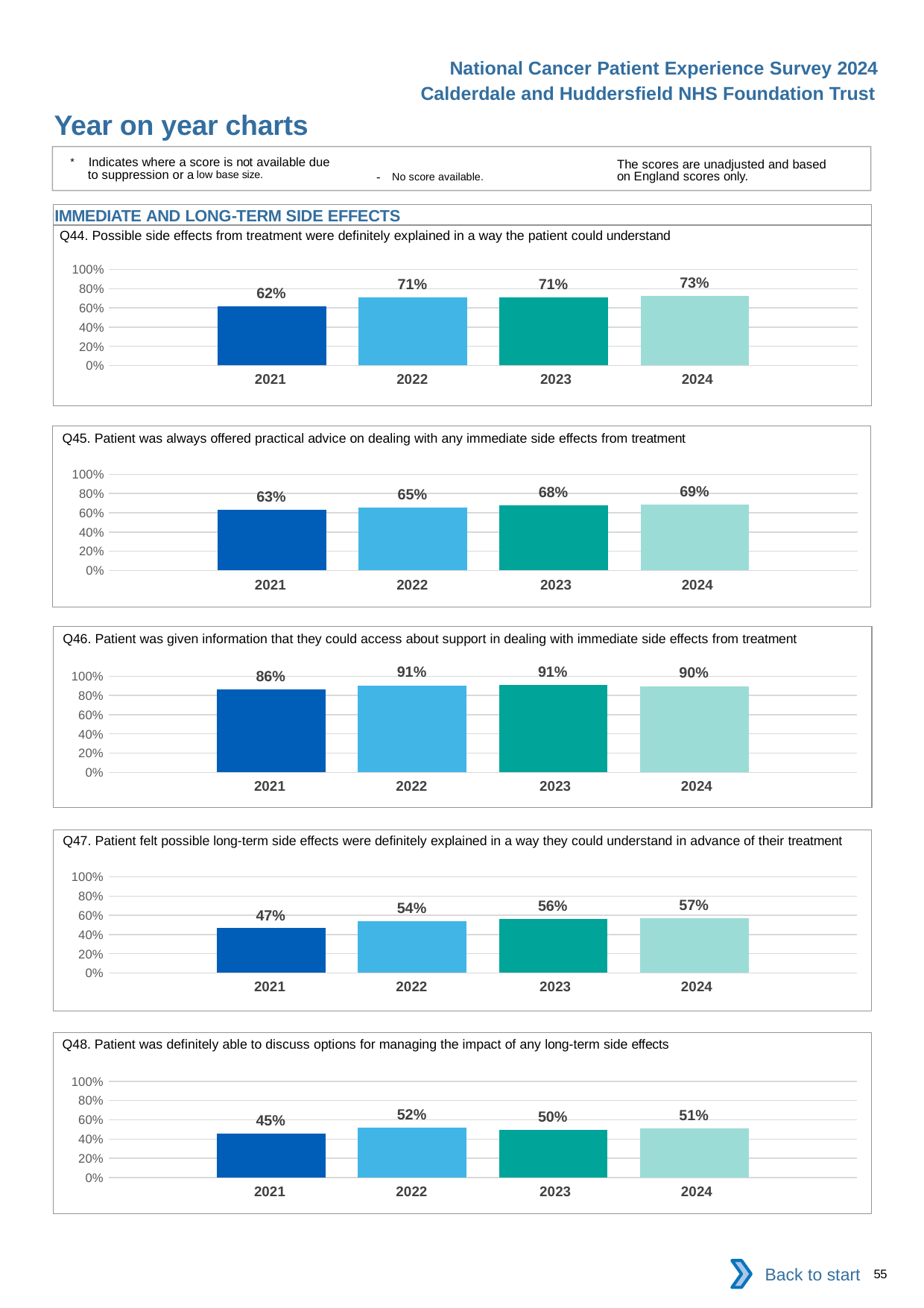
In the Q46 chart, is the value for 2022 larger or smaller than the value for 2024? larger In the Q45 chart, do the values rise or fall from 2021 to 2024? rise In the Q47 chart, what is the difference between the 2022 and 2021 values? 7% In the Q44 chart, what is the value for 2024? 73% In the Q47 chart, which year has the highest value? 2024 In the Q46 chart, what is the value for 2021? 86% In the Q44 chart, which year has the lowest value? 2021 What kind of chart is the Q44 chart? bar chart In the Q48 chart, what is the value for 2023? 50% In the Q48 chart, which year has the highest value? 2022 In the Q45 chart, what is the difference between the 2024 and 2021 values? 6% How many years are shown on the x axis of the Q48 chart? 4